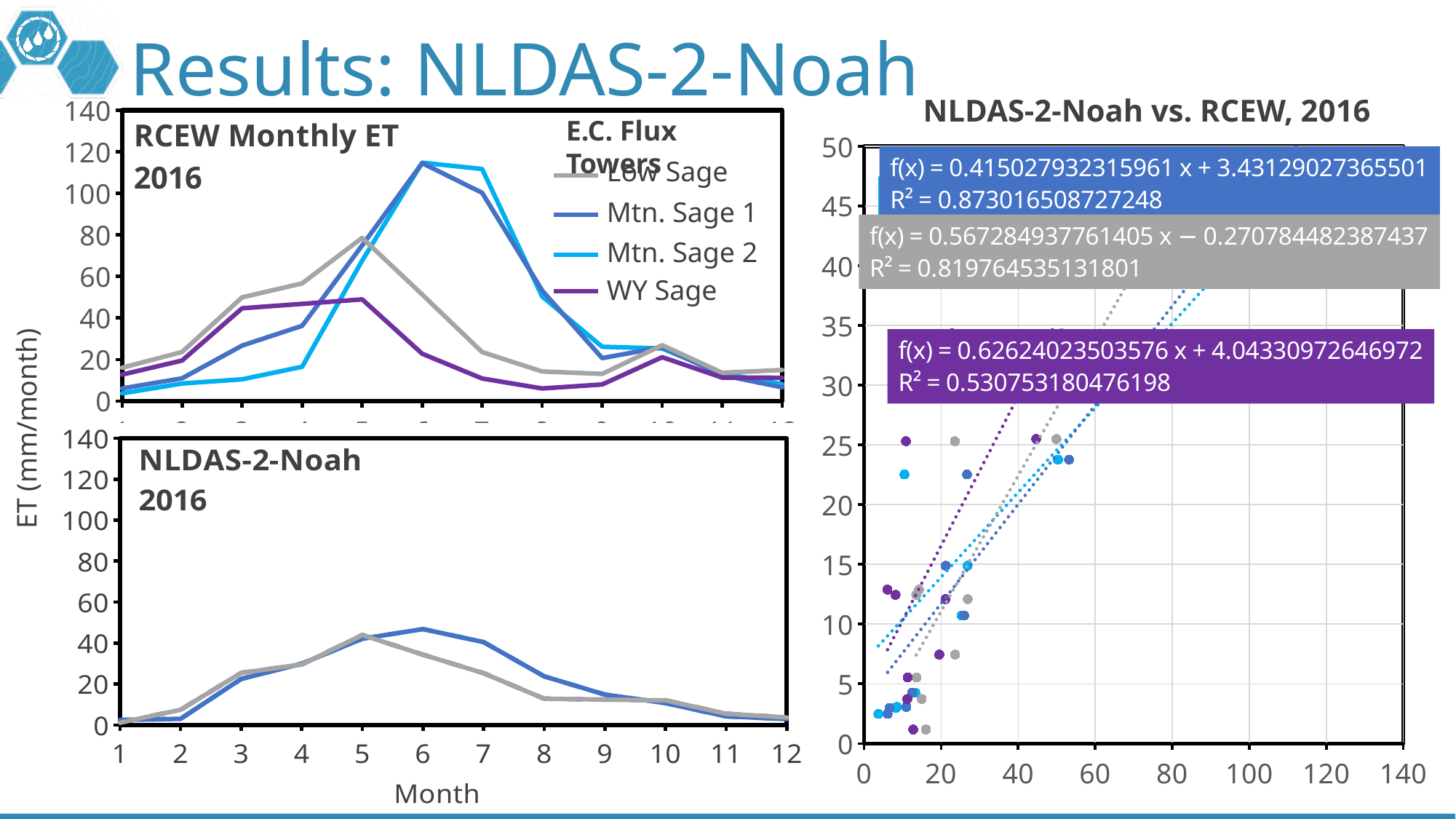
In the 'NLDAS-2-Noah vs. RCEW, 2016' chart, what is the R² value shown in the purple box? 0.530753180476198 In the 'NLDAS-2-Noah 2016' chart on the bottom left, is the peak value of the blue series in month 6 greater or less than 40? greater What kind of chart is the 'RCEW Monthly ET 2016' chart on the top left? line chart In the 'RCEW Monthly ET 2016' chart, which is larger in month 5: Low Sage or WY Sage? Low Sage In the 'RCEW Monthly ET 2016' chart, in which month does the Low Sage series reach its highest value? 5 In the 'RCEW Monthly ET 2016' chart, is the value for Mtn. Sage 2 in month 6 greater or less than 100? greater In the 'RCEW Monthly ET 2016' chart, is the value for Low Sage in month 5 greater or less than 60? greater How many series does the legend of the 'RCEW Monthly ET 2016' chart list? 4 In the 'RCEW Monthly ET 2016' chart, how many months are plotted along the x axis? 12 What kind of chart is the 'NLDAS-2-Noah vs. RCEW, 2016' chart on the right? scatter chart In the 'NLDAS-2-Noah 2016' chart on the bottom left, do the values rise or fall from month 6 to month 9? fall